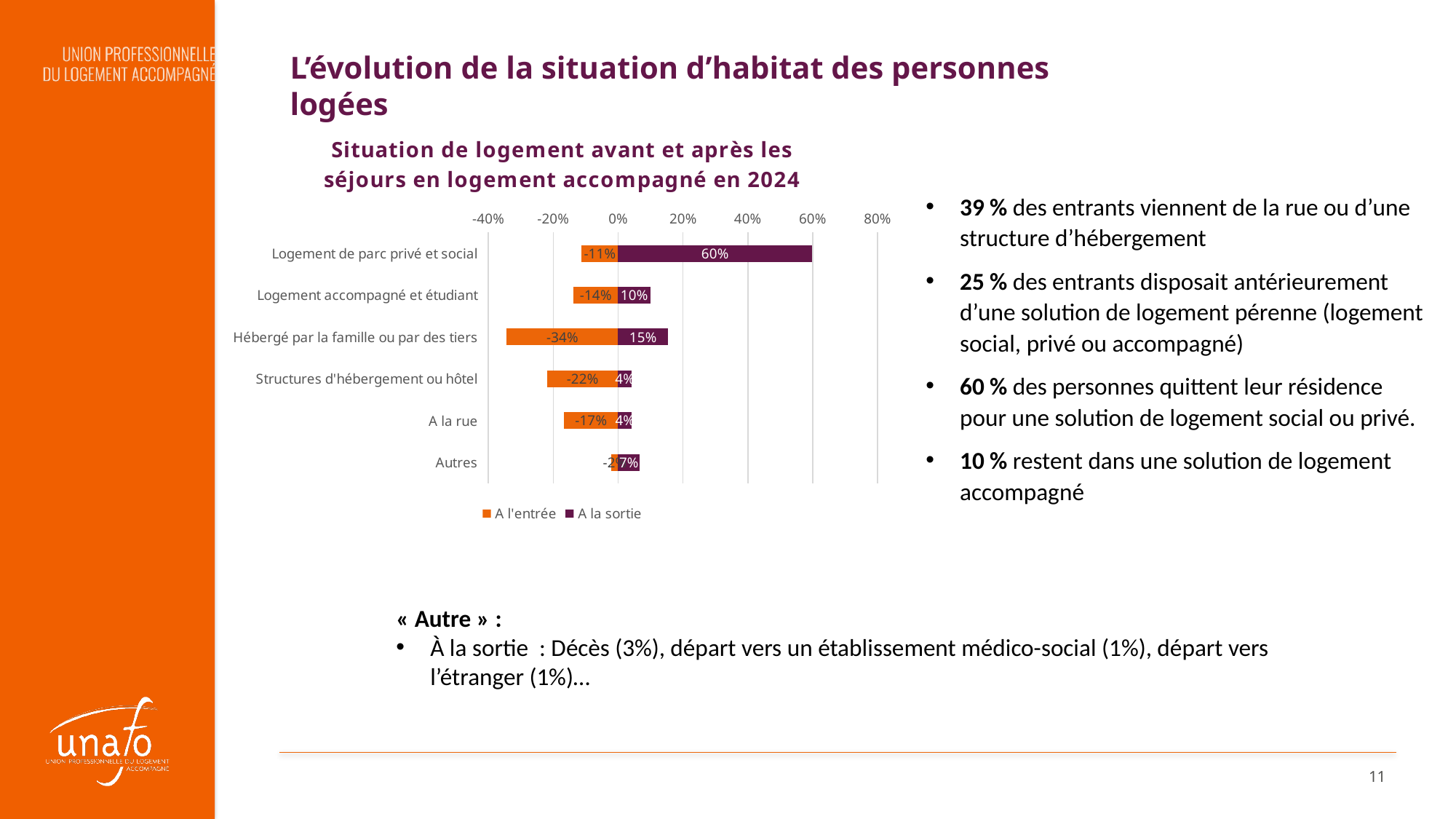
What is the 'A l'entrée' value for 'Hébergé par la famille ou par des tiers'? -34% What is the difference between the 'A la sortie' values for 'Logement de parc privé et social' and 'Hébergé par la famille ou par des tiers'? 45% Which series is shown in orange in the chart legend? A l'entrée What type of chart is shown on the slide? bar chart How many series does the chart legend list? 2 How many categories are shown on the chart? 6 Which category has the highest 'A la sortie' value? Logement de parc privé et social What is the 'A la sortie' value for 'Logement de parc privé et social'? 60% Which is larger in 'A la sortie': 'Hébergé par la famille ou par des tiers' or 'Logement accompagné et étudiant'? Hébergé par la famille ou par des tiers What is the 'A l'entrée' value for 'Structures d'hébergement ou hôtel'? -22% What is the 'A la sortie' value for 'Logement accompagné et étudiant'? 10% Which category has the largest 'A l'entrée' bar (most negative value)? Hébergé par la famille ou par des tiers